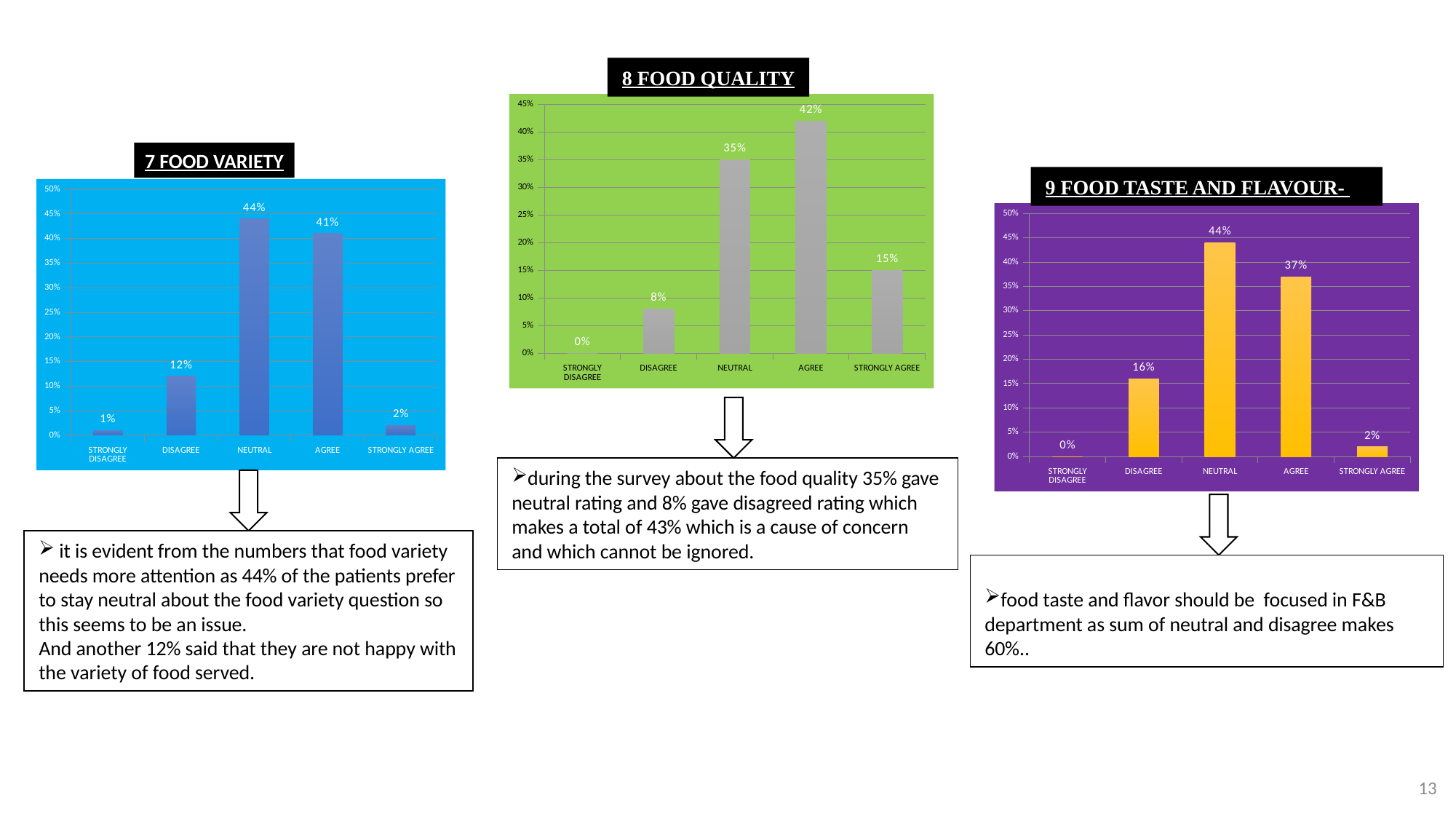
In the '7 FOOD VARIETY' chart, which category has the lowest value? STRONGLY DISAGREE In the '9 FOOD TASTE AND FLAVOUR-' chart, what is the difference between NEUTRAL and STRONGLY AGREE? 42% In the '7 FOOD VARIETY' chart, what is the value for NEUTRAL? 44% In the '8 FOOD QUALITY' chart, what is the value for AGREE? 42% In the '8 FOOD QUALITY' chart, which category has the highest value? AGREE In the '8 FOOD QUALITY' chart, what is the value for STRONGLY DISAGREE? 0% In the '8 FOOD QUALITY' chart, how many categories are shown on the x axis? 5 What colour are the bars in the '9 FOOD TASTE AND FLAVOUR-' chart? Yellow What kind of chart is the '7 FOOD VARIETY' chart? Bar chart In the '9 FOOD TASTE AND FLAVOUR-' chart, what is the value for DISAGREE? 16% In the '9 FOOD TASTE AND FLAVOUR-' chart, which is larger, NEUTRAL or AGREE? NEUTRAL In the '7 FOOD VARIETY' chart, what is the difference between NEUTRAL and AGREE? 3%